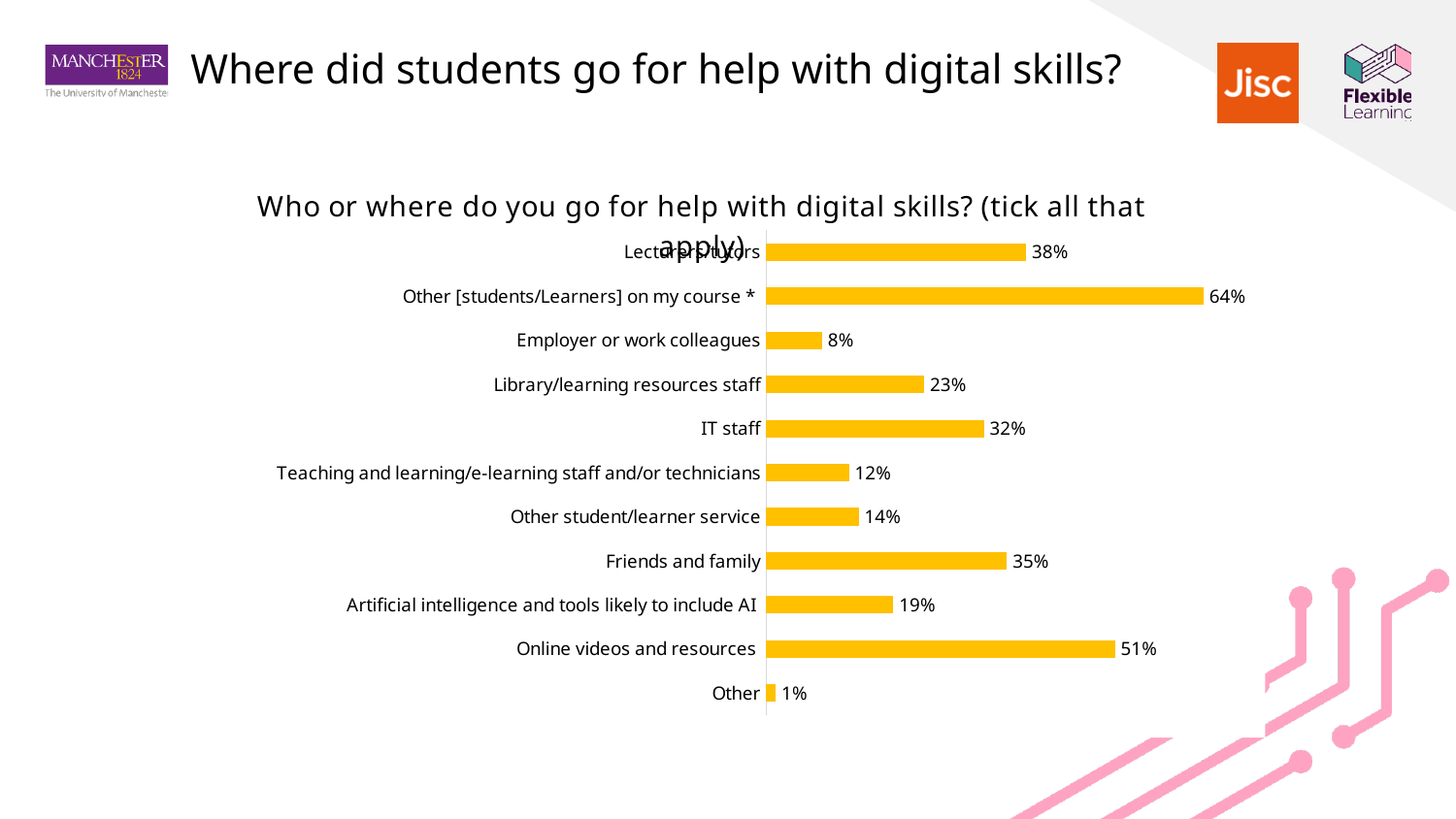
What is the difference between the values for Friends and family and Library/learning resources staff? 12% Which category has the highest value in the chart? Other [students/Learners] on my course * Which category has the lowest value in the chart? Other How many categories are shown in the chart? 11 What percentage of students go to other students/learners on their course for help with digital skills? 64% Which is larger: the value for Employer or work colleagues or the value for Other student/learner service? Other student/learner service What is the value for Artificial intelligence and tools likely to include AI? 19% What is the difference between the values for Online videos and resources and Teaching and learning/e-learning staff and/or technicians? 39% What is the value for IT staff? 32% What is the value for Online videos and resources? 51% What kind of chart is shown on the slide? Bar chart What colour are the bars in the chart? Yellow